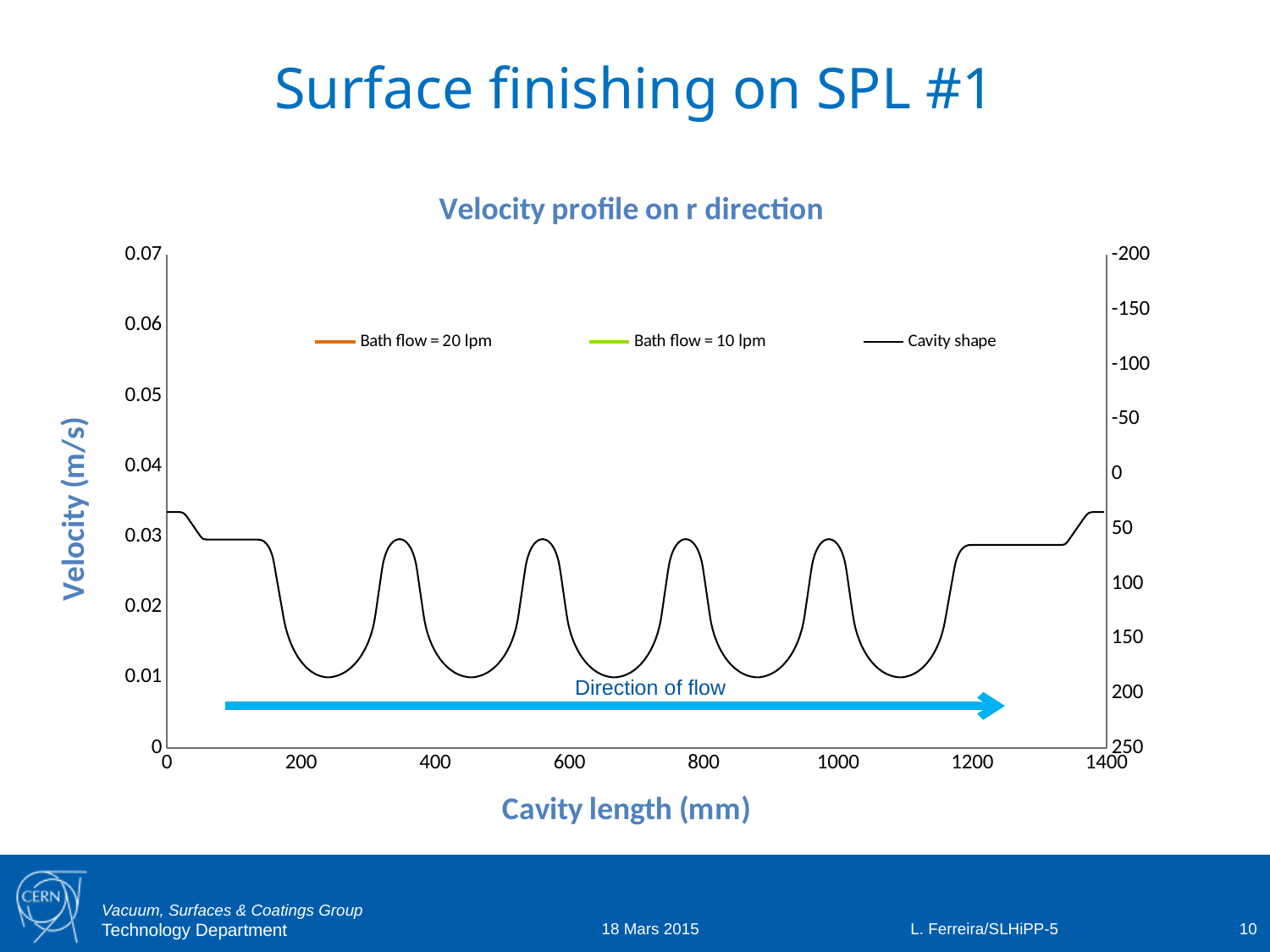
What is the maximum value shown on the left y axis? 0.07 What is the maximum value shown on the x axis? 1400 What type of chart is shown on the slide? line chart What is the topmost tick value on the right-hand y axis? -200 How many dips (cells) does the Cavity shape line show between the flat end sections? 5 What is the bottommost tick value on the right-hand y axis? 250 What is the label of the x axis? Cavity length (mm) How many series does the chart legend list? 3 What is the x-axis tick spacing on the chart? 200 What is the title of the chart? Velocity profile on r direction Which legend entry is drawn in black? Cavity shape